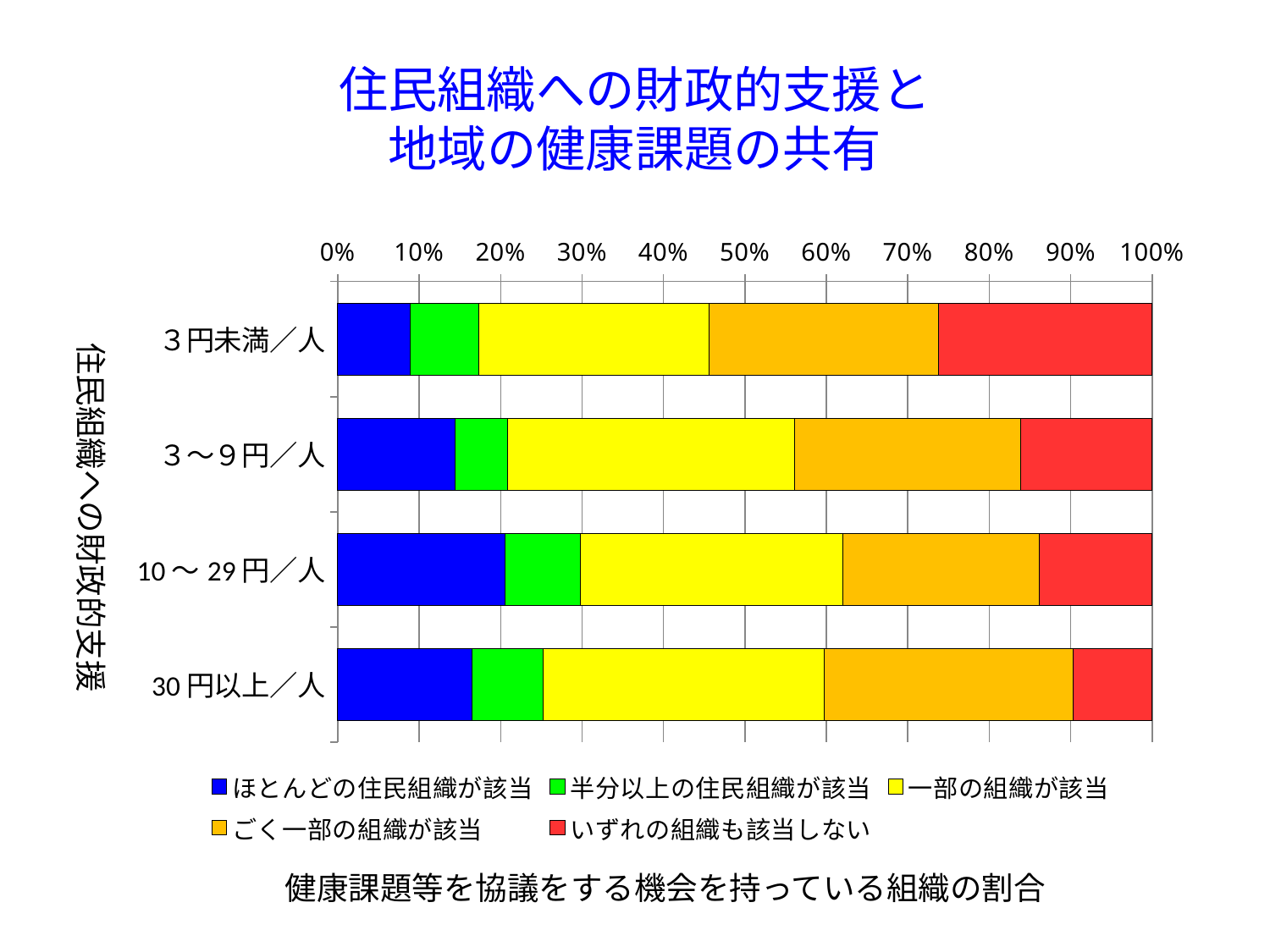
Which category has the smallest いずれの組織も該当しない (red) segment? 30円以上／人 Which has the larger ほとんどの住民組織が該当 (blue) segment: 3円未満／人 or 3～9円／人? 3～9円／人 What is the title of the chart on the slide? 住民組織への財政的支援と地域の健康課題の共有 Going from 3円未満／人 down to 30円以上／人, does the いずれの組織も該当しない (red) share rise or fall? Fall What kind of chart is shown on the slide? Stacked bar chart Which category has the largest いずれの組織も該当しない (red) segment? 3円未満／人 Which category has the largest ほとんどの住民組織が該当 (blue) segment? 10～29円／人 Is the いずれの組織も該当しない share for 3円未満／人 greater or less than 20%? greater How many series does the legend list? 5 Which category has the smallest ほとんどの住民組織が該当 (blue) segment? 3円未満／人 Is the いずれの組織も該当しない share for 30円以上／人 greater or less than 20%? less How many categories (levels of financial support) are plotted on the y axis? 4